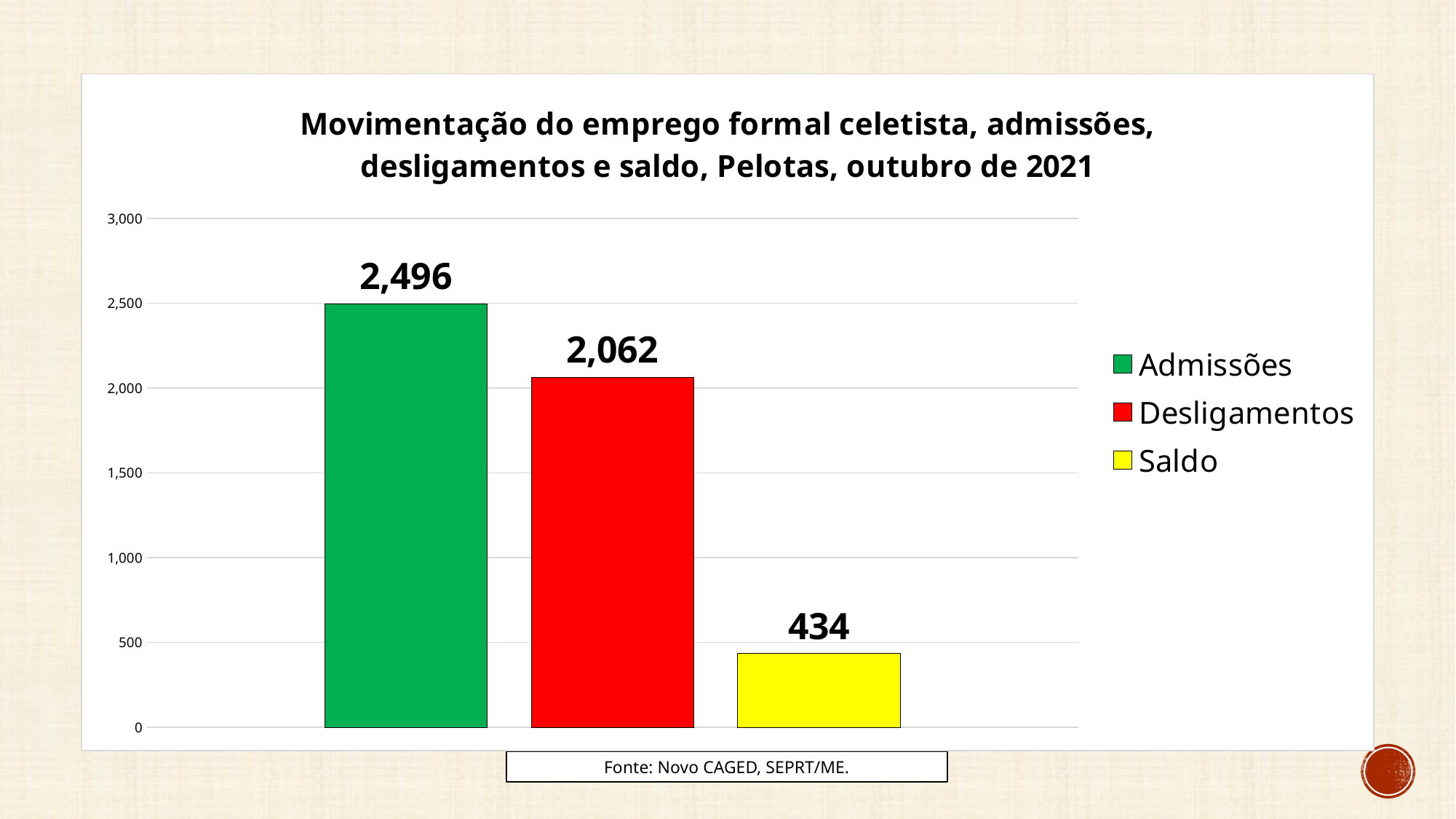
What is the value for Desligamentos? 2,062 What is the difference between Admissões and Desligamentos? 434 Is the value for Saldo greater or less than 500? less Which series has the lowest value? Saldo Which is larger, Desligamentos or Saldo? Desligamentos How many series does the legend list? 3 How many bars are plotted in the chart? 3 What colour is the bar for Saldo? yellow What is the value for Admissões? 2,496 What kind of chart is shown on the slide? bar chart Which series has the highest value? Admissões What is the value for Saldo? 434